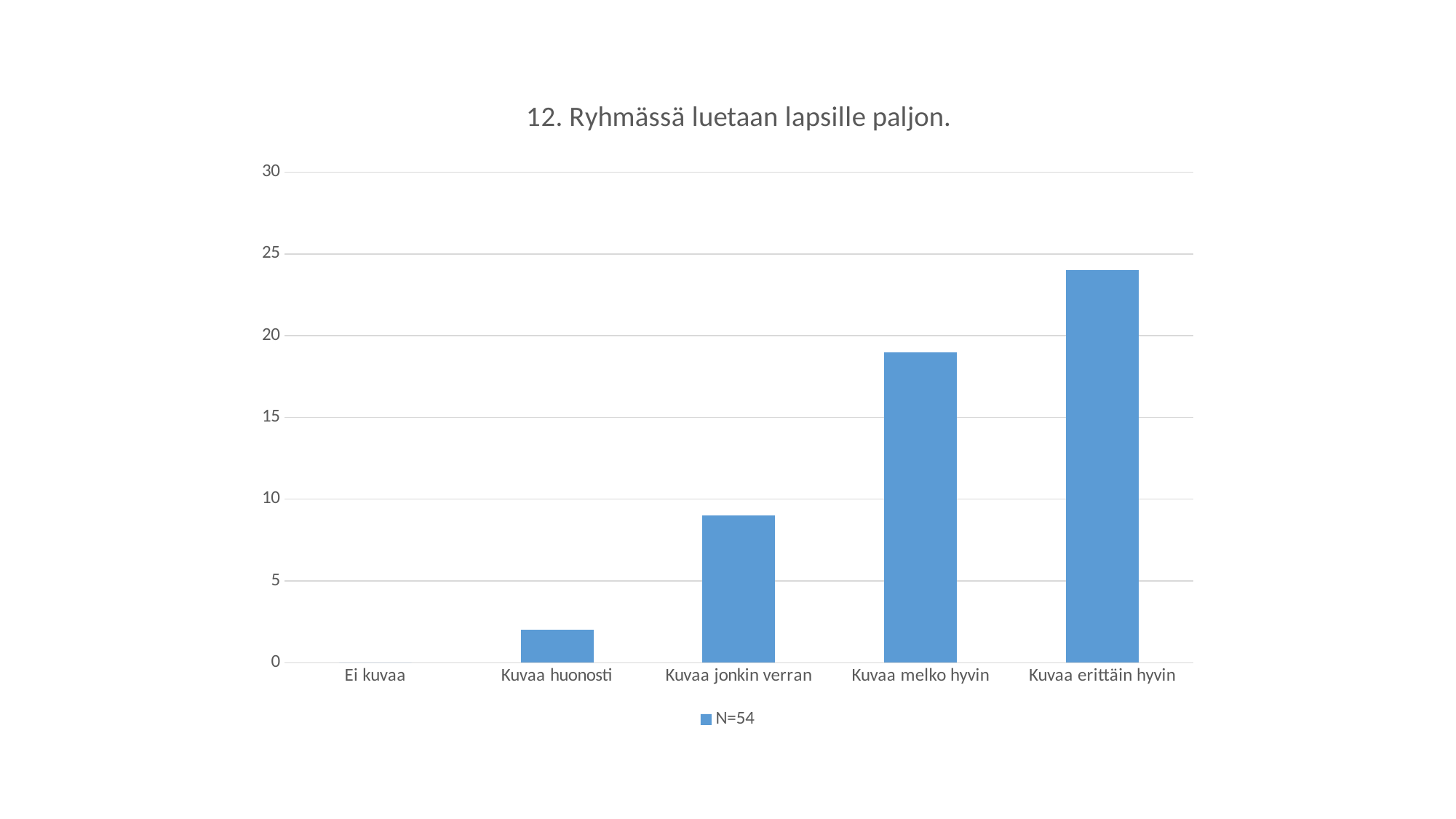
What is the title of the chart? 12. Ryhmässä luetaan lapsille paljon. Is the value for Kuvaa jonkin verran greater or less than 10? less What entry does the legend list? N=54 Is the value for Kuvaa huonosti greater or less than 5? less Which is larger, the value for Kuvaa melko hyvin or the value for Kuvaa jonkin verran? Kuvaa melko hyvin Which category has the lowest value? Ei kuvaa What kind of chart is shown on the slide? bar chart How many series does the legend list? 1 Which category has the highest value? Kuvaa erittäin hyvin Is the value for Kuvaa erittäin hyvin greater or less than 20? greater Do the values rise or fall from left to right along the x axis? rise How many categories are shown on the x axis? 5